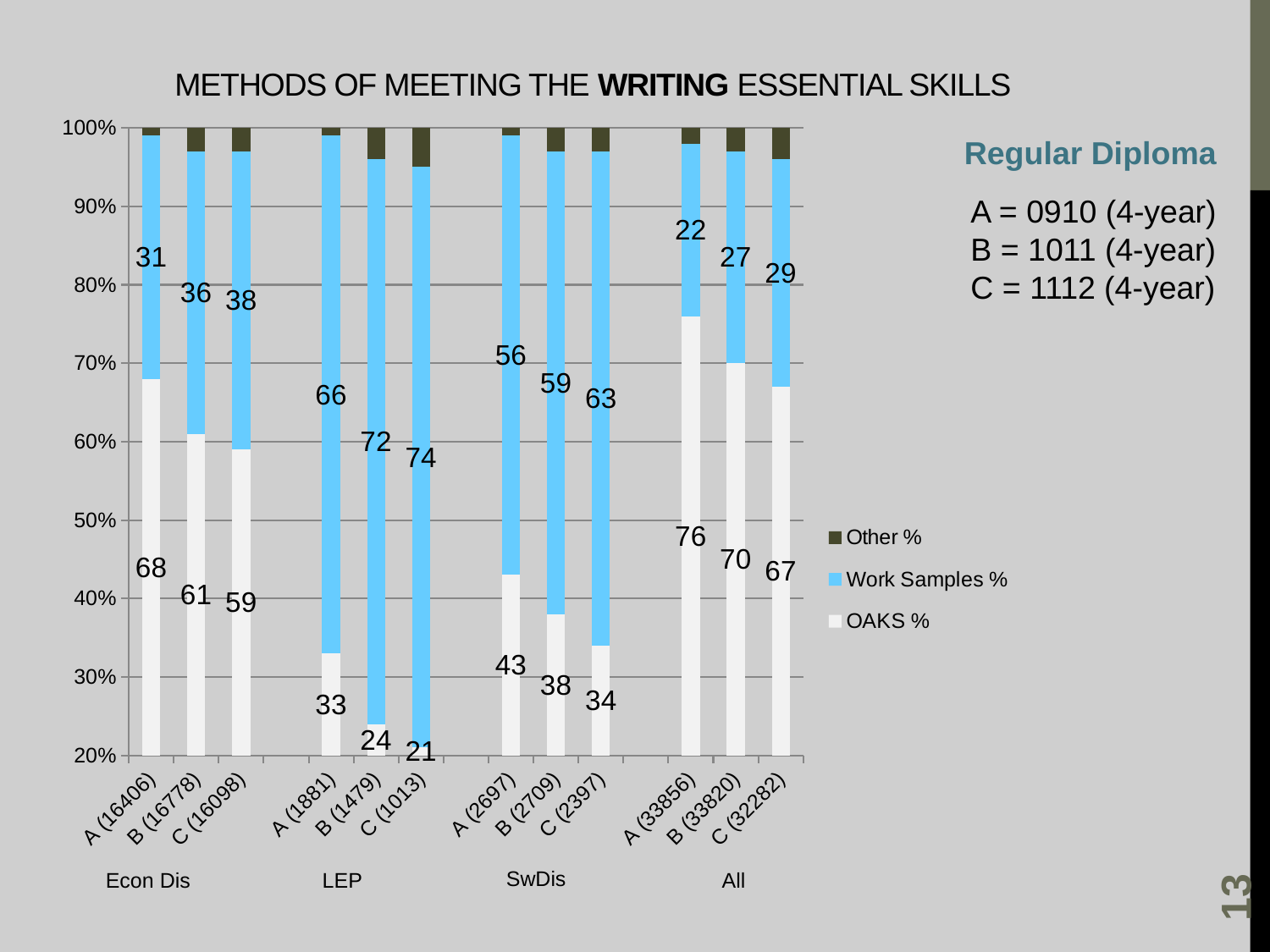
What is the difference between the OAKS % values for A (16406) and C (16098) in the Econ Dis group? 9 What type of chart is shown on the slide? stacked bar chart How many bars are plotted in the chart? 12 Which bar has the highest OAKS % value? A (33856) Which series is shown in light blue in the legend? Work Samples % What is the Work Samples % value for A (33856) in the All group? 22 What is the Work Samples % value for C (1013) in the LEP group? 74 How many series does the legend list? 3 Which bar has the lowest OAKS % value? C (1013) Which is larger, the Work Samples % for B (1479) in LEP or the Work Samples % for B (2709) in SwDis? B (1479) in LEP What is the OAKS % value for A (16406) in the Econ Dis group? 68 What is the OAKS % value for B (2709) in the SwDis group? 38